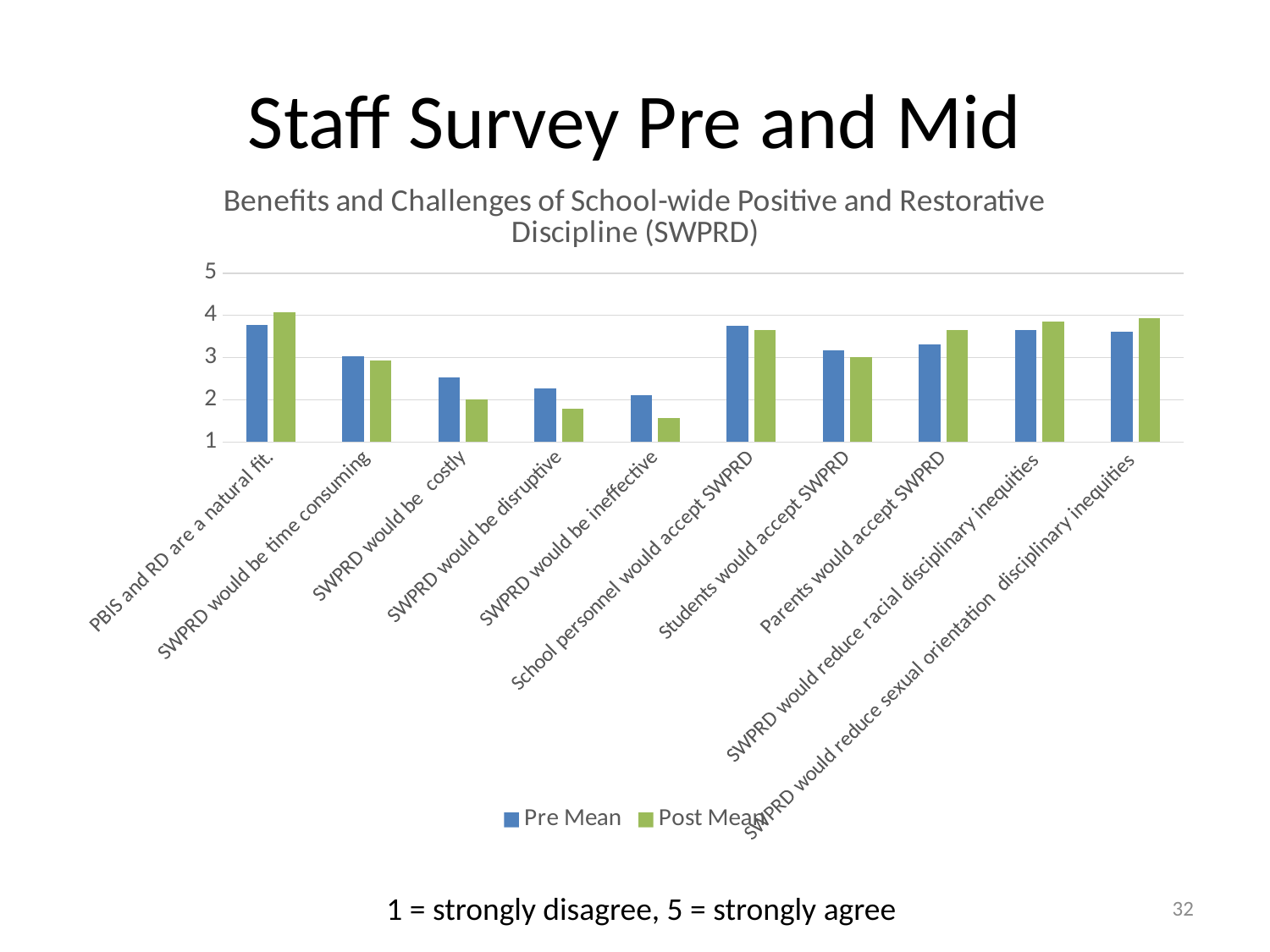
What is the title of the chart? Benefits and Challenges of School-wide Positive and Restorative Discipline (SWPRD) For "Parents would accept SWPRD", which is larger, the Pre Mean or the Post Mean? Post Mean For "SWPRD would be costly", which is larger, the Pre Mean or the Post Mean? Pre Mean What kind of chart is shown on the slide? Bar chart Which category has the highest Post Mean value? PBIS and RD are a natural fit. How many series does the legend list? 2 Is the Post Mean value for "SWPRD would be ineffective" greater or less than 2? less How many categories are shown on the x axis? 10 Is the Pre Mean value for "Parents would accept SWPRD" greater or less than 3? greater Which category has the lowest Post Mean value? SWPRD would be ineffective Is the Pre Mean value for "SWPRD would be costly" greater or less than 2? greater